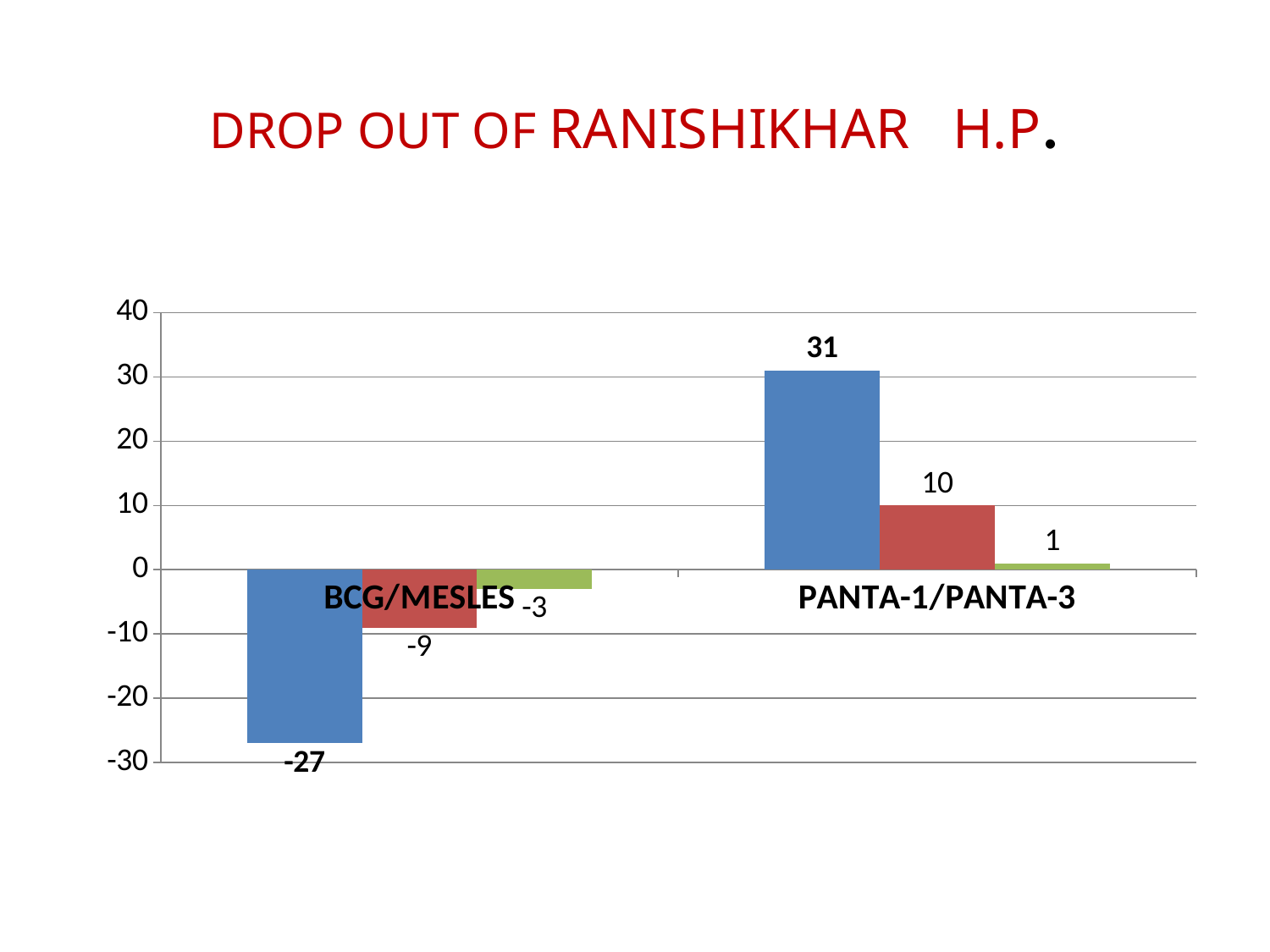
What is the value of the green bar for BCG/MESLES? -3 What is the title of the slide? DROP OUT OF RANISHIKHAR H.P. What is the value of the blue bar for PANTA-1/PANTA-3? 31 Which bar has the lowest value on the chart? The blue bar for BCG/MESLES (-27) What is the value of the red bar for PANTA-1/PANTA-3? 10 Which category has the highest blue bar value? PANTA-1/PANTA-3 How many categories are shown on the x axis? 2 Which is larger, the red bar for PANTA-1/PANTA-3 or the green bar for PANTA-1/PANTA-3? The red bar (10) What kind of chart is shown on the slide? Bar chart What is the value of the red bar for BCG/MESLES? -9 What is the difference between the blue bar values for PANTA-1/PANTA-3 and BCG/MESLES? 58 What is the value of the blue bar for BCG/MESLES? -27